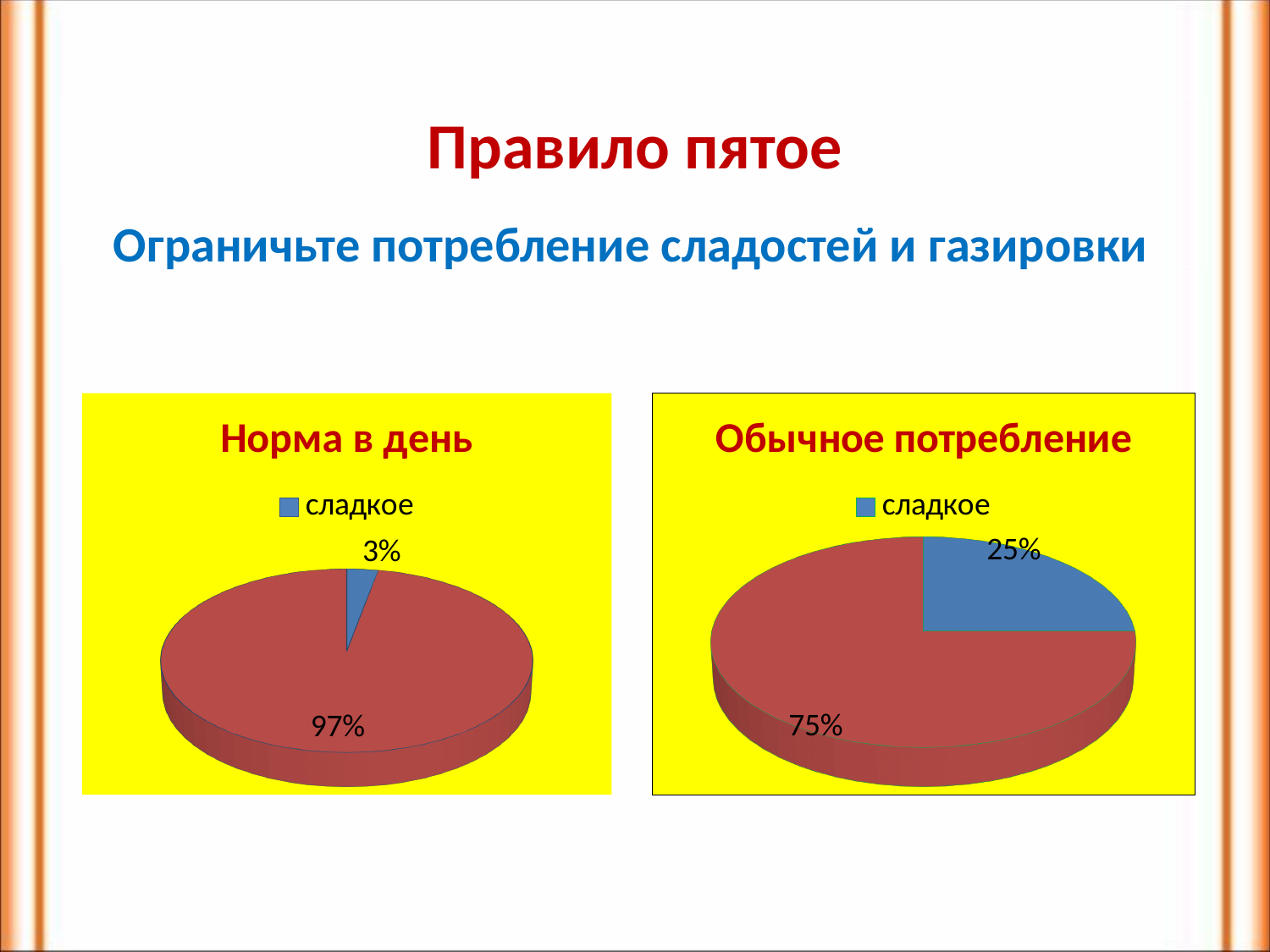
What type of chart is the "Норма в день" chart? pie chart In the "Норма в день" chart, what percentage is shown on the red slice? 97% How many entries does the legend of the "Норма в день" chart list? 1 In the "Обычное потребление" chart, what share does the "сладкое" slice have? 25% In the "Норма в день" chart, what share does the "сладкое" slice have? 3% In the "Обычное потребление" chart, what percentage is shown on the red slice? 75% How many slices does the "Обычное потребление" pie chart have? 2 In the "Норма в день" chart, which slice is the largest? the red slice (97%) What is the title of the chart on the right side of the slide? Обычное потребление What is the difference between the "сладкое" share in the "Обычное потребление" chart and in the "Норма в день" chart? 22% Which chart has the larger "сладкое" slice, "Норма в день" or "Обычное потребление"? Обычное потребление In the "Обычное потребление" chart, which slice is the smallest? сладкое (25%)